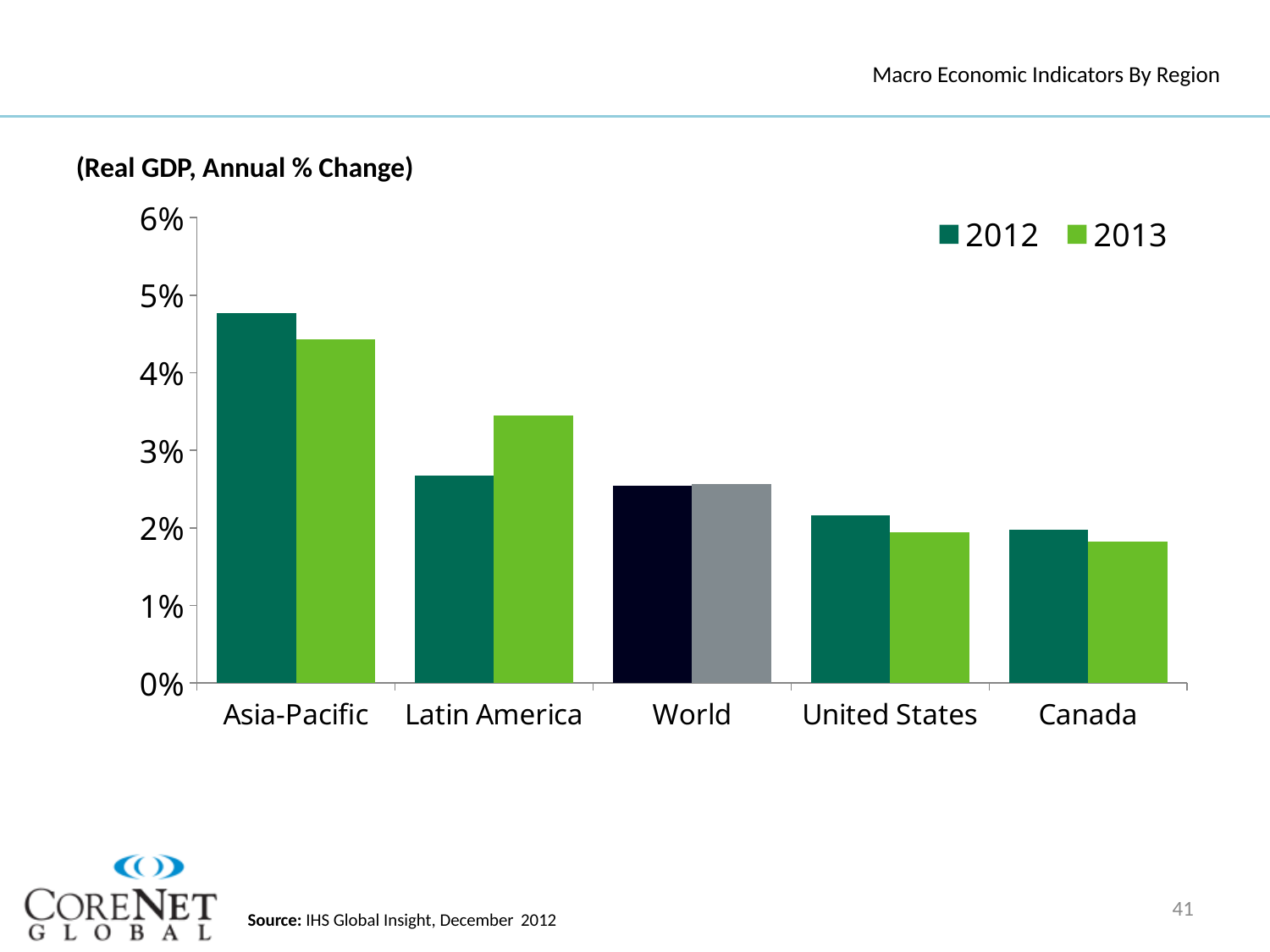
Is the 2013 value for Canada greater or less than 2%? less Is the 2013 value for Latin America greater or less than 3%? greater Do the 2012 values rise or fall moving from Asia-Pacific to Canada along the x axis? Fall How many series does the chart's legend list? 2 What are the two entries in the chart's legend? 2012 and 2013 For Asia-Pacific, which year has the larger value, 2012 or 2013? 2012 Which region has the lowest Real GDP annual % change for 2013? Canada What kind of chart is shown on the slide? Bar chart For Latin America, which year has the larger value, 2012 or 2013? 2013 Is the 2012 value for Asia-Pacific greater or less than 4%? greater How many regions are shown on the x axis of the chart? 5 Which region has the highest Real GDP annual % change for 2012? Asia-Pacific